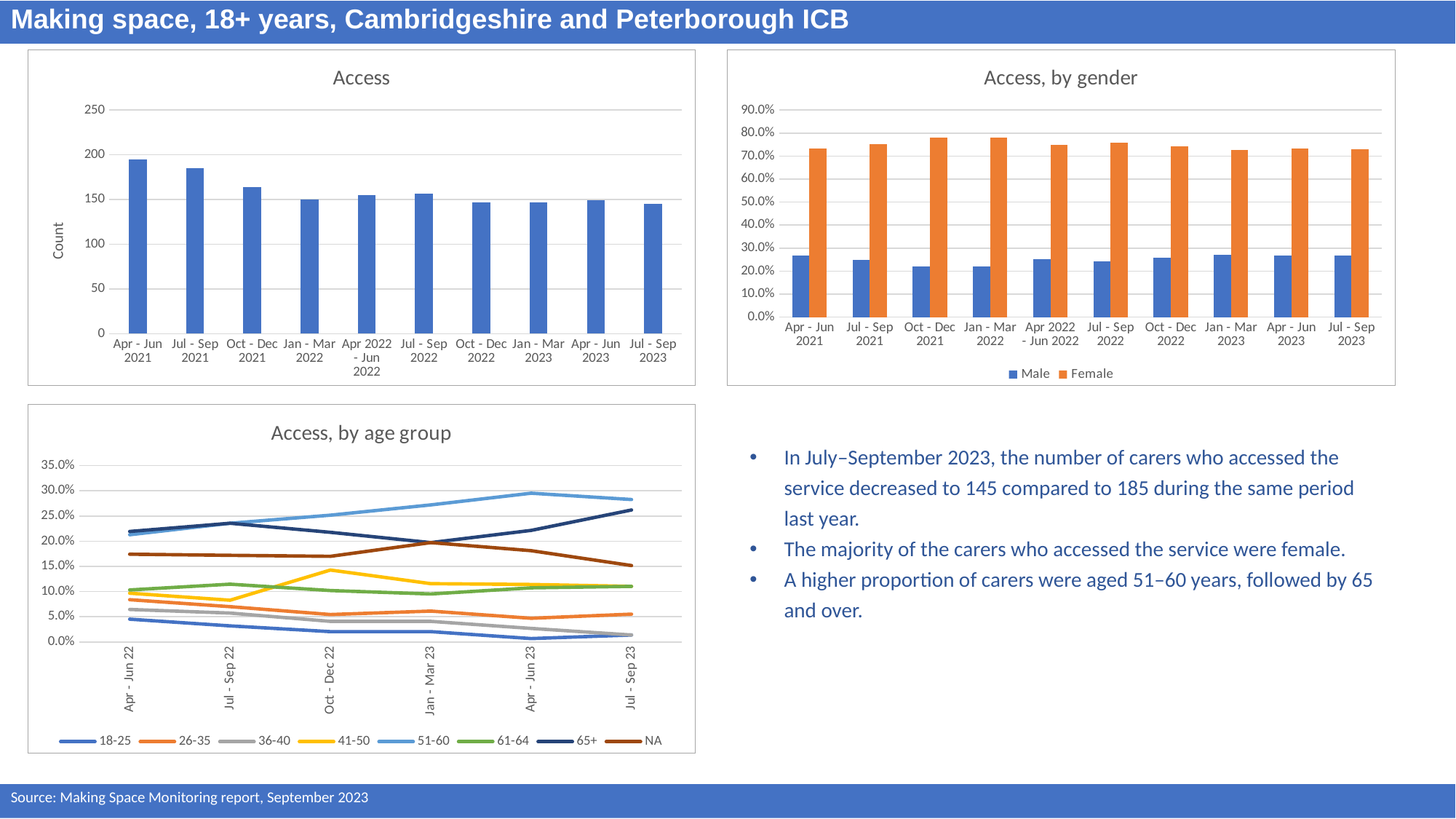
What kind of chart is the "Access" chart? bar chart In the "Access" chart, is the count for Jan - Mar 2022 greater or less than 200? less In the "Access" chart, which period has the highest count? Apr - Jun 2021 How many series does the legend of the "Access, by gender" chart list? 2 In the "Access" chart, is the count for Apr - Jun 2021 greater or less than 150? greater How many time periods are shown on the x axis of the "Access" chart? 10 In the "Access" chart, do the counts generally rise or fall from Apr - Jun 2021 to Jul - Sep 2023? fall In the "Access, by gender" chart, is the Male value for Oct - Dec 2021 greater or less than 30.0%? less In the "Access, by age group" chart, which age group has the highest value at Jul - Sep 23? 51-60 What kind of chart is the "Access, by age group" chart? line chart In the "Access, by gender" chart, which is larger for Apr - Jun 2021: Male or Female? Female In the "Access" chart, which is larger: the count for Apr - Jun 2021 or the count for Oct - Dec 2021? Apr - Jun 2021